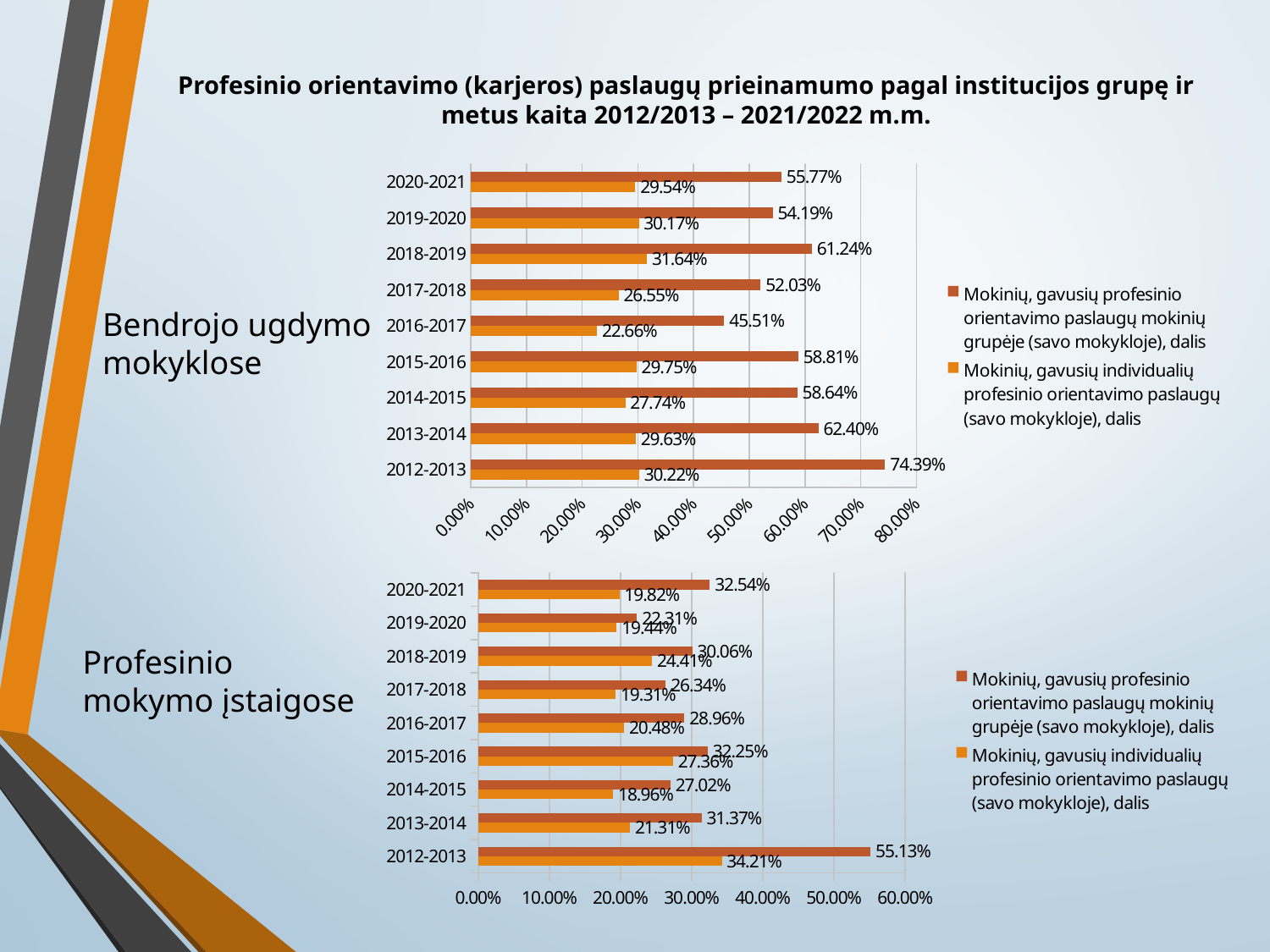
In the 'Bendrojo ugdymo mokyklose' chart, what is the value for 2016-2017 for the series 'Mokinių, gavusių individualių profesinio orientavimo paslaugų (savo mokykloje), dalis'? 22.66% In the 'Profesinio mokymo įstaigose' chart, which year has the lowest value for the individual-services series? 2014-2015 In the 'Bendrojo ugdymo mokyklose' chart, which year has the highest value for the group-services series? 2012-2013 In the 'Bendrojo ugdymo mokyklose' chart, what is the value for 2012-2013 for the series 'Mokinių, gavusių profesinio orientavimo paslaugų mokinių grupėje (savo mokykloje), dalis'? 74.39% In the 'Profesinio mokymo įstaigose' chart, what is the group-services value for 2019-2020? 22.31% In the 'Bendrojo ugdymo mokyklose' chart, how many year categories are shown? 9 In the 'Profesinio mokymo įstaigose' chart, what is the value for 2012-2013 for the series 'Mokinių, gavusių individualių profesinio orientavimo paslaugų (savo mokykloje), dalis'? 34.21% In the 'Bendrojo ugdymo mokyklose' chart, what is the difference between the group-services value and the individual-services value for 2020-2021? 26.23% In the 'Bendrojo ugdymo mokyklose' chart, which year has the lowest value for the group-services series? 2016-2017 How many series does the legend of the 'Profesinio mokymo įstaigose' chart list? 2 In the 'Profesinio mokymo įstaigose' chart, is the group-services value for 2020-2021 or for 2015-2016 larger? 2020-2021 What type of chart is the 'Bendrojo ugdymo mokyklose' chart? Bar chart